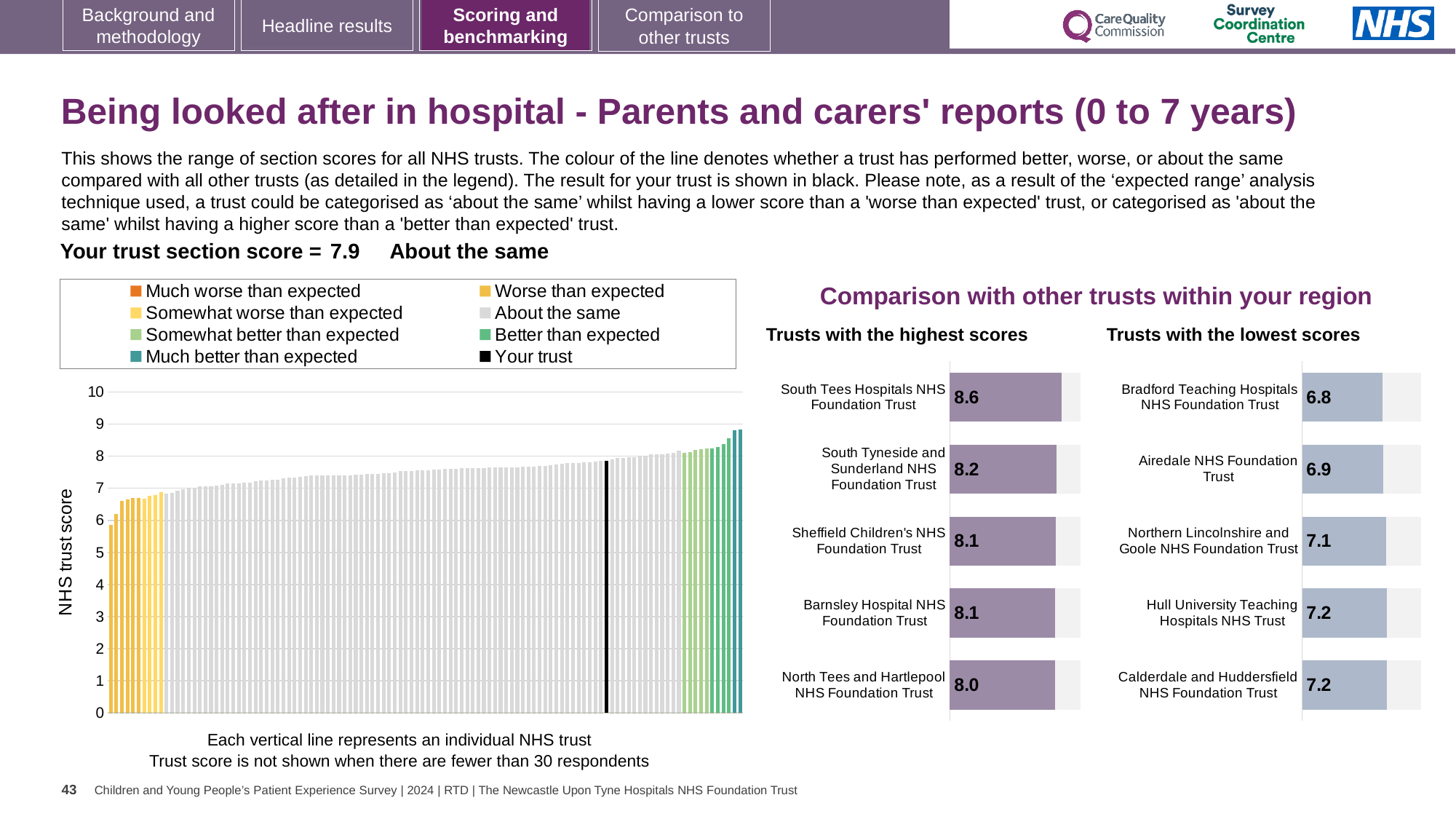
In the 'Trusts with the highest scores' chart, what is the score for South Tees Hospitals NHS Foundation Trust? 8.6 In the 'Trusts with the lowest scores' chart, what is the score for Airedale NHS Foundation Trust? 6.9 In the 'Trusts with the lowest scores' chart, which has the larger score: Hull University Teaching Hospitals NHS Trust or Airedale NHS Foundation Trust? Hull University Teaching Hospitals NHS Trust What is the y-axis label of the large chart on the left? NHS trust score In the 'Trusts with the highest scores' chart, what is the difference between the scores of South Tees Hospitals NHS Foundation Trust and North Tees and Hartlepool NHS Foundation Trust? 0.6 What kind of chart is the large chart on the left showing the range of section scores for all NHS trusts? bar chart In the 'Trusts with the lowest scores' chart, which trust has the lowest score? Bradford Teaching Hospitals NHS Foundation Trust How many trusts are shown in the 'Trusts with the highest scores' chart? 5 In the 'Trusts with the highest scores' chart, which trust has the highest score? South Tees Hospitals NHS Foundation Trust What is the section score for your trust shown on the slide? 7.9 How many entries does the legend of the large chart on the left list? 8 In the large chart on the left, do the trust scores rise or fall from left to right? rise